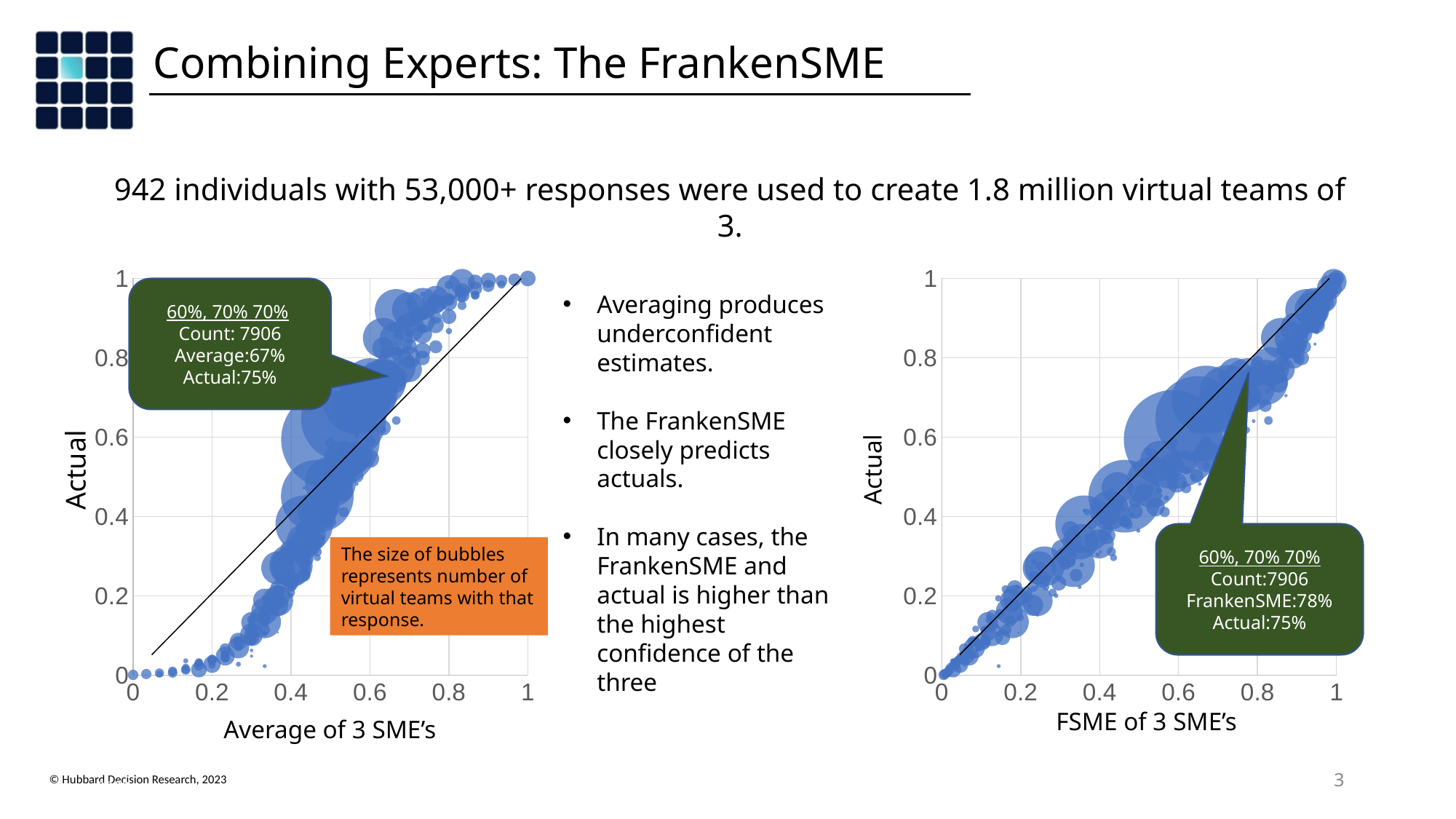
In the right chart, do the Actual values generally rise or fall as the FSME of 3 SME's increases along the x axis? Rise In the left chart's callout for the 60%, 70% 70% response, what is the Average? 67% In the left chart's callout for the 60%, 70% 70% response, what is the Count? 7906 In the right chart's callout for the 60%, 70% 70% response, what is the Actual? 75% What is the x-axis label of the right chart? FSME of 3 SME's What is the x-axis label of the left chart? Average of 3 SME's In the left chart's callout for the 60%, 70% 70% response, what is the Actual? 75% What kind of chart is the left chart on the slide? Bubble chart For the 60%, 70% 70% response, what is the difference between the FrankenSME value (78%) and the Actual (75%) shown in the right chart's callout? 3 percentage points For the 60%, 70% 70% response, what is the difference between the Actual (75%) and the Average (67%) shown in the left chart's callout? 8 percentage points For the 60%, 70% 70% response, which is larger: the Average shown in the left chart's callout or the FrankenSME value shown in the right chart's callout? FrankenSME In the right chart's callout for the 60%, 70% 70% response, what is the FrankenSME value? 78%